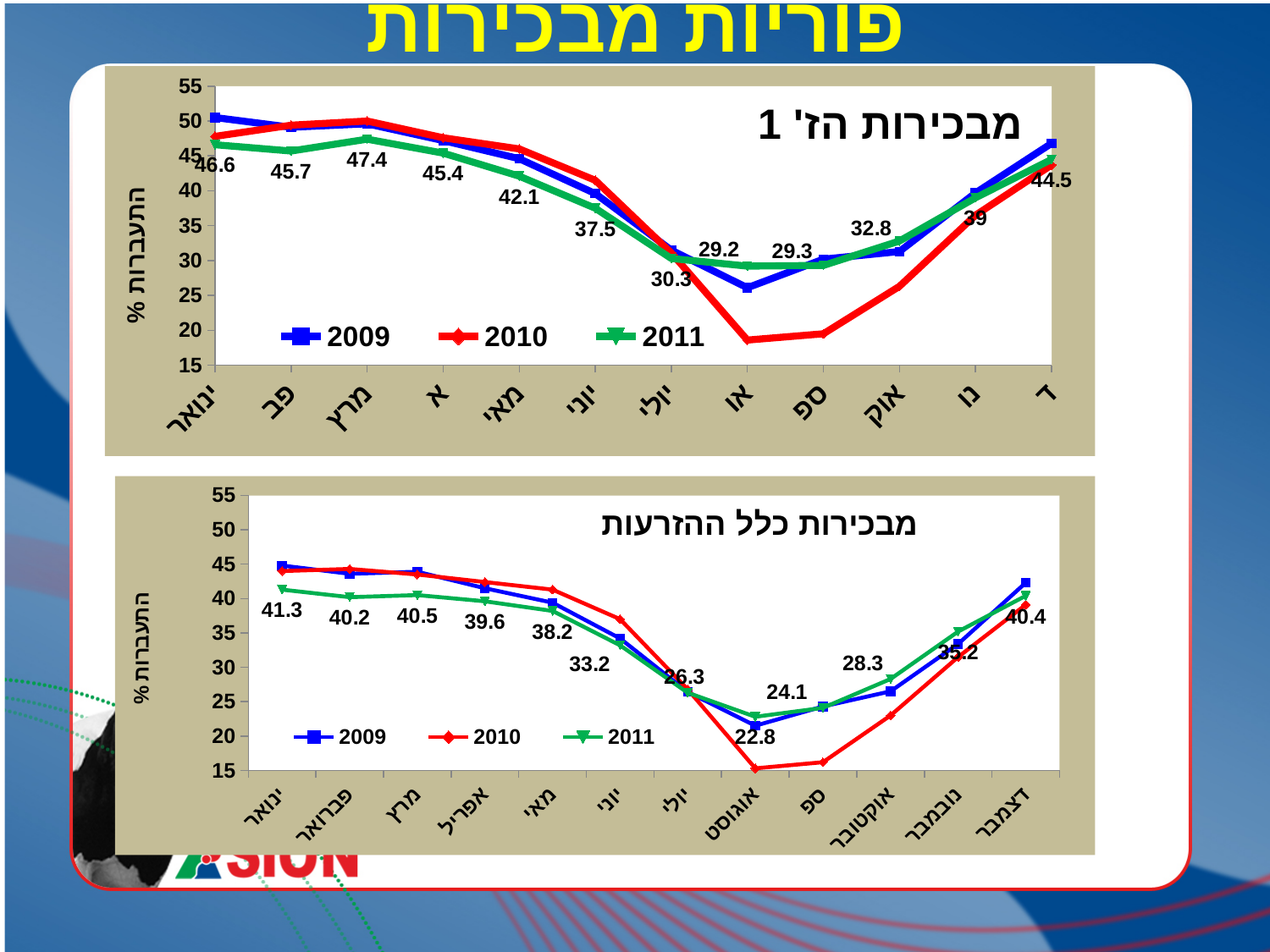
In the bottom chart (מבכירות כלל ההזרעות), which month has the highest labelled 2011 value? ינואר In the top chart (מבכירות הז' 1), what is the labelled value for 2011 in July (יולי)? 30.3 What kind of chart is the bottom chart (מבכירות כלל ההזרעות)? line chart In the bottom chart (מבכירות כלל ההזרעות), what is the labelled value for 2011 in August (אוגוסט)? 22.8 In the bottom chart (מבכירות כלל ההזרעות), what is the difference between the labelled 2011 values for November (35.2) and October (28.3)? 6.9 In the top chart (מבכירות הז' 1), what is the difference between the labelled 2011 values for January (46.6) and December (44.5)? 2.1 In the top chart (מבכירות הז' 1), which series has the higher value in August: 2009 or 2010? 2009 In the top chart (מבכירות הז' 1), what is the labelled value for 2011 in March (מרץ)? 47.4 How many series does the legend of the top chart list? 3 In the bottom chart (מבכירות כלל ההזרעות), is the 2010 value in August greater or less than 20? less In the top chart (מבכירות הז' 1), is the 2010 value in August greater or less than 20? less In the top chart (מבכירות הז' 1), which month has the lowest labelled 2011 value? אוגוסט (או)